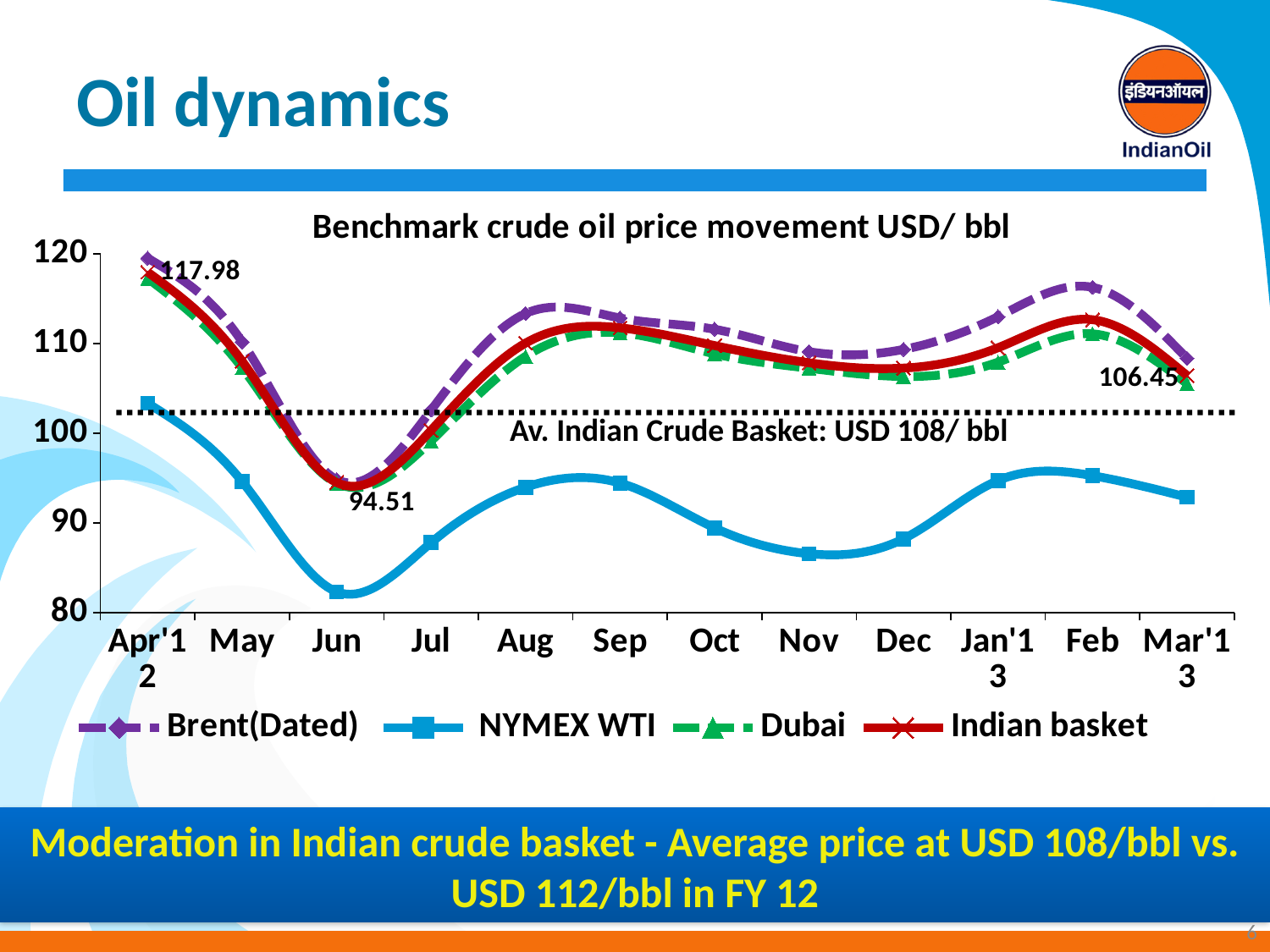
In which month is the Indian basket price lowest? Jun What is the Indian basket price in Mar'13? 106.45 What kind of chart is shown on the slide? Line chart What is the Indian basket price in Jun? 94.51 What is the title of the chart? Benchmark crude oil price movement USD/ bbl By how much did the Indian basket price fall from Apr'12 to Jun? 23.47 Which series is larger in Nov, Brent(Dated) or NYMEX WTI? Brent(Dated) How many series does the legend list? 4 What is the Indian basket price in Apr'12? 117.98 What is the difference between the Indian basket price in Apr'12 and in Mar'13? 11.53 How many months are plotted along the x axis? 12 Is the NYMEX WTI value in Jun greater or less than 90? less